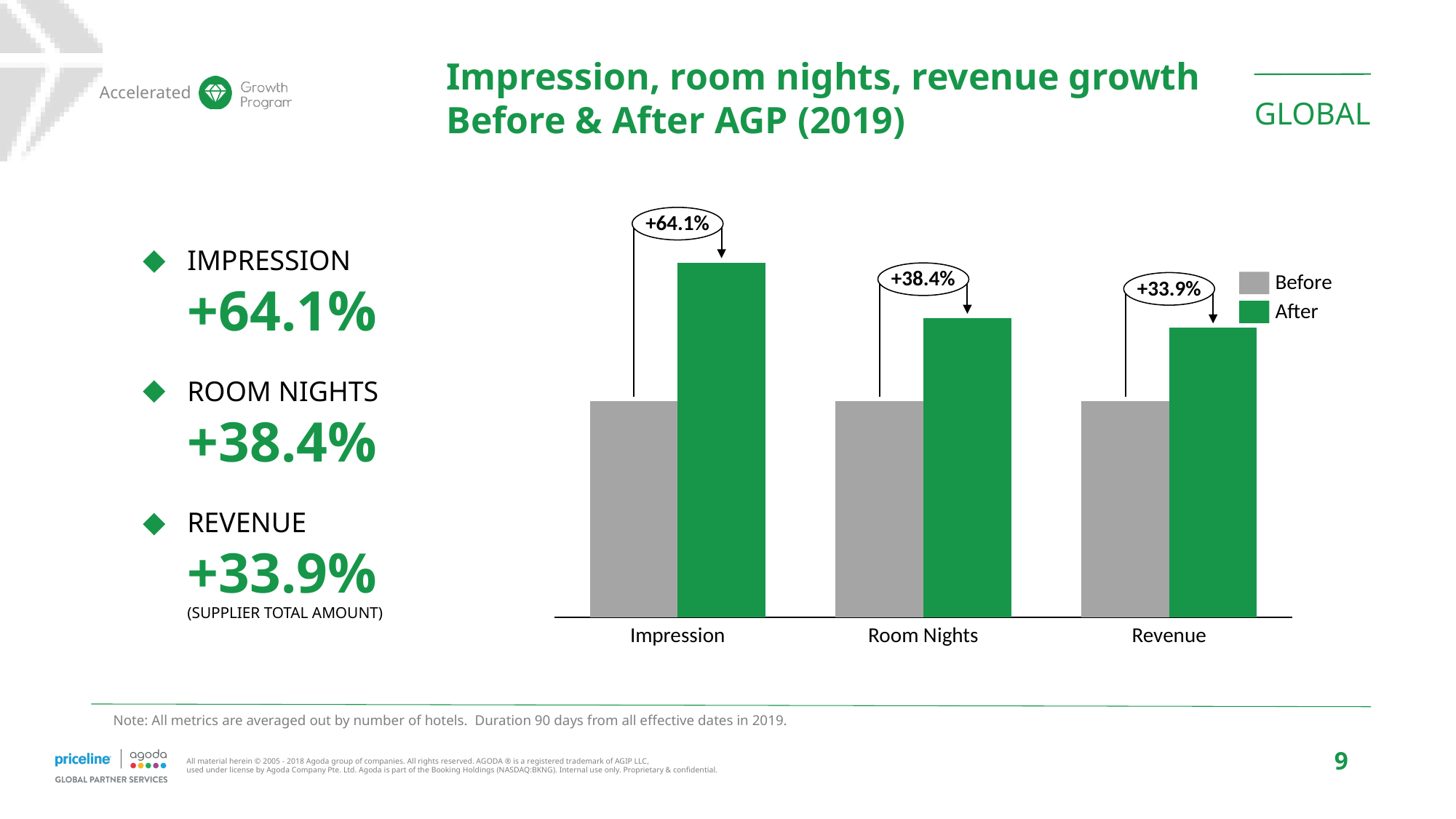
How many categories are shown on the x axis of the chart? 3 Which category shows the smallest growth from Before to After? Revenue How many percentage points higher is the growth for Impression than for Room Nights? 25.7 How many series does the chart legend list? 2 What growth percentage is shown for Room Nights in the chart? +38.4% What growth percentage is shown for Revenue in the chart? +33.9% What growth percentage is shown for Impression in the chart? +64.1% Which has the taller After bar, Impression or Room Nights? Impression Which category shows the largest growth from Before to After? Impression How many percentage points higher is the growth for Room Nights than for Revenue? 4.5 What type of chart is shown on the slide? Bar chart Which colour represents the After series in the chart? Green